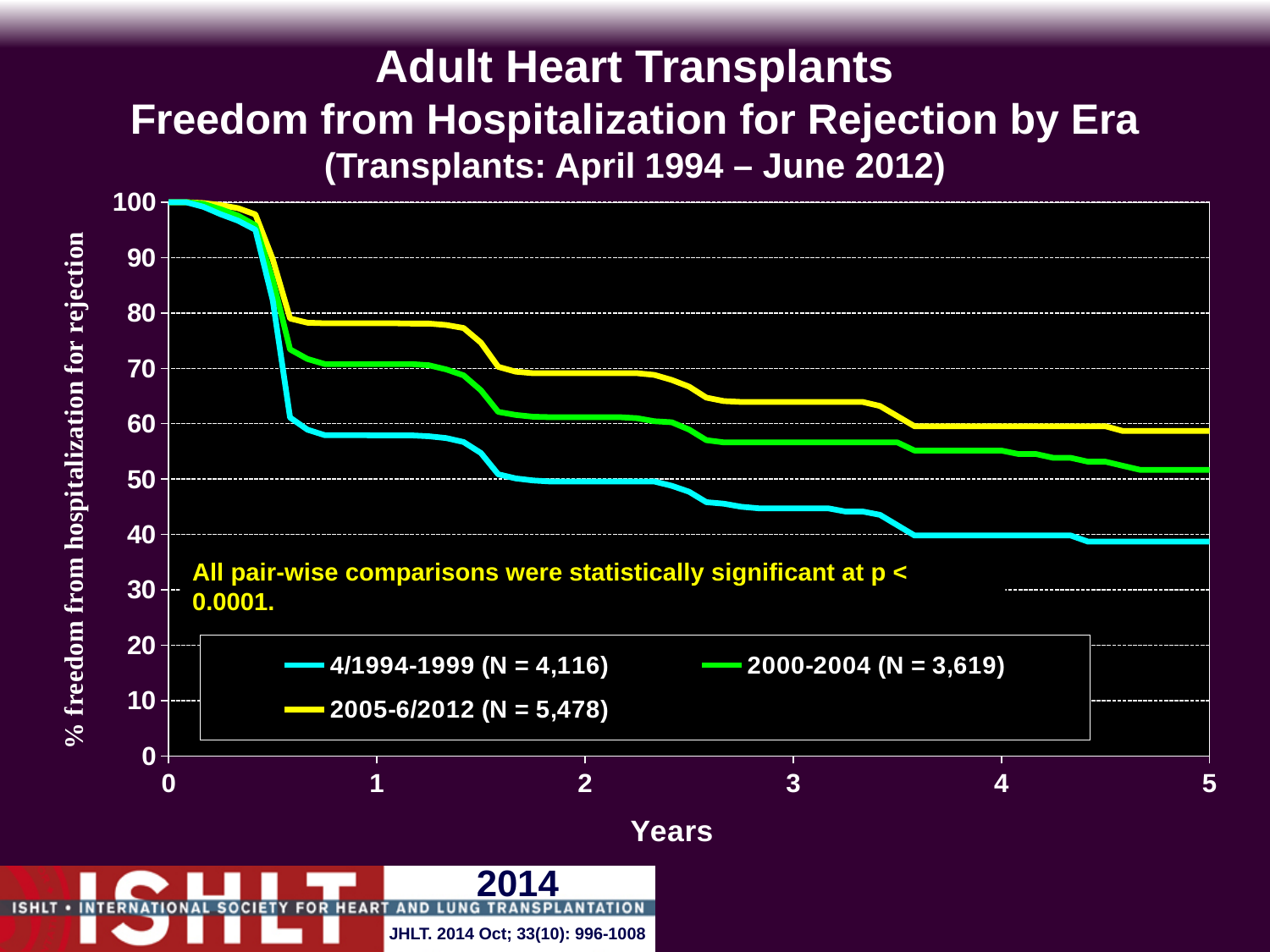
Is the value for the 4/1994-1999 era at year 3 greater or less than 50? less At year 2, which era has the larger value: 2005-6/2012 or 4/1994-1999? 2005-6/2012 Which era has the highest freedom from hospitalization for rejection at 5 years? 2005-6/2012 What is the % freedom from hospitalization for rejection for all eras at year 0? 100 Is the value for the 2000-2004 era at year 3 greater or less than 50? greater What kind of chart is shown on the slide? Line chart Do the values for each era rise or fall as years increase? Fall Is the value for the 2005-6/2012 era at year 5 greater or less than 50? greater What is the label of the x axis? Years Which era has the lowest freedom from hospitalization for rejection at 5 years? 4/1994-1999 How many series does the legend list? 3 What is the N for the 2005-6/2012 era shown in the legend? 5,478